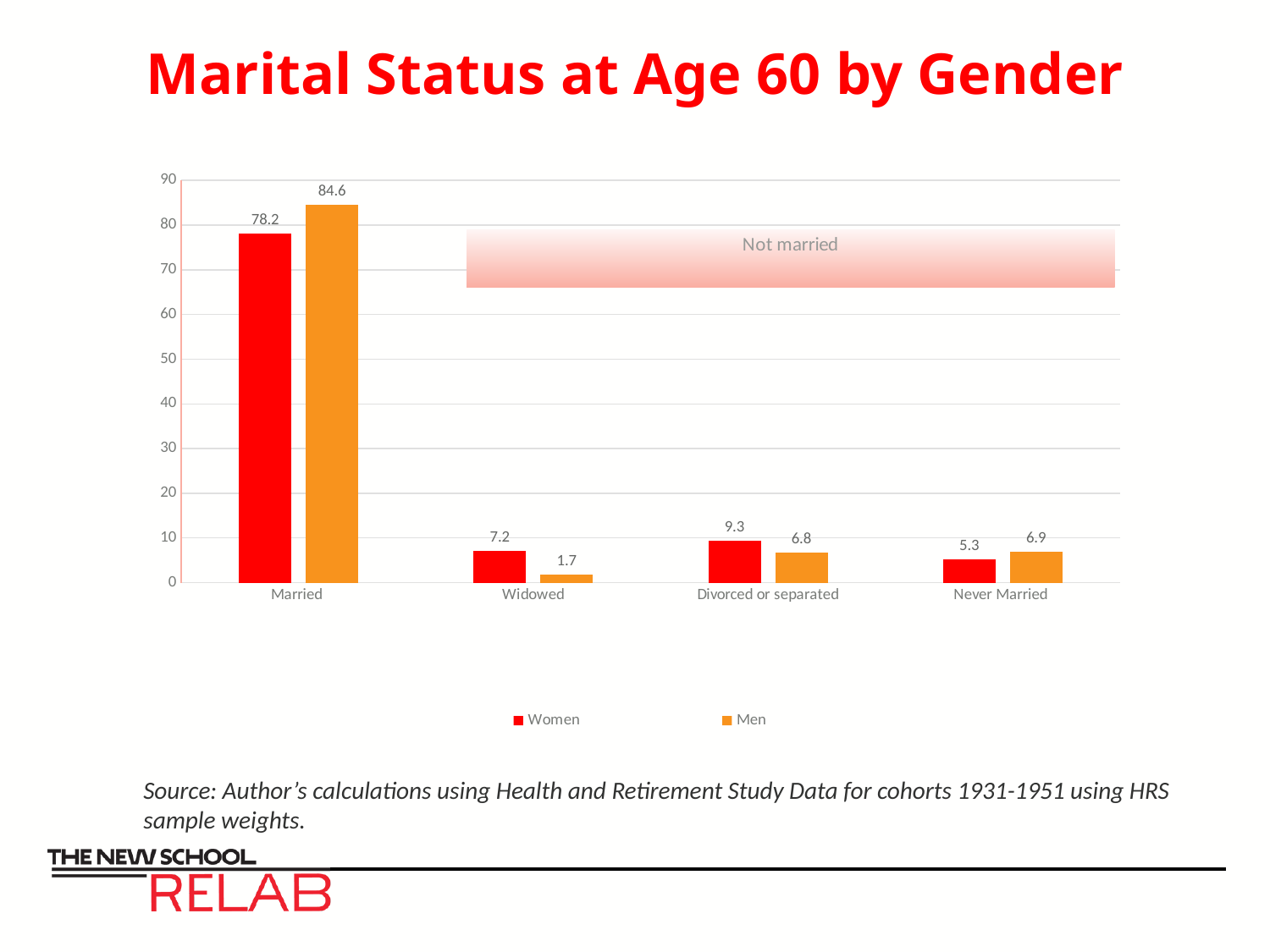
Which category has the highest value for Men? Married What is the difference between the Men and Women values in the Married category? 6.4 What is the value for Women in the Divorced or separated category? 9.3 What is the value for Men in the Never Married category? 6.9 What is the value for Men in the Widowed category? 1.7 Which is larger in the Widowed category, the value for Women or the value for Men? Women How many categories are shown on the x axis? 4 Is the value for Women in the Married category greater or less than 70? greater What kind of chart is shown on the slide? bar chart Which category has the lowest value for Women? Never Married What is the value for Women in the Married category? 78.2 How many series does the legend list? 2